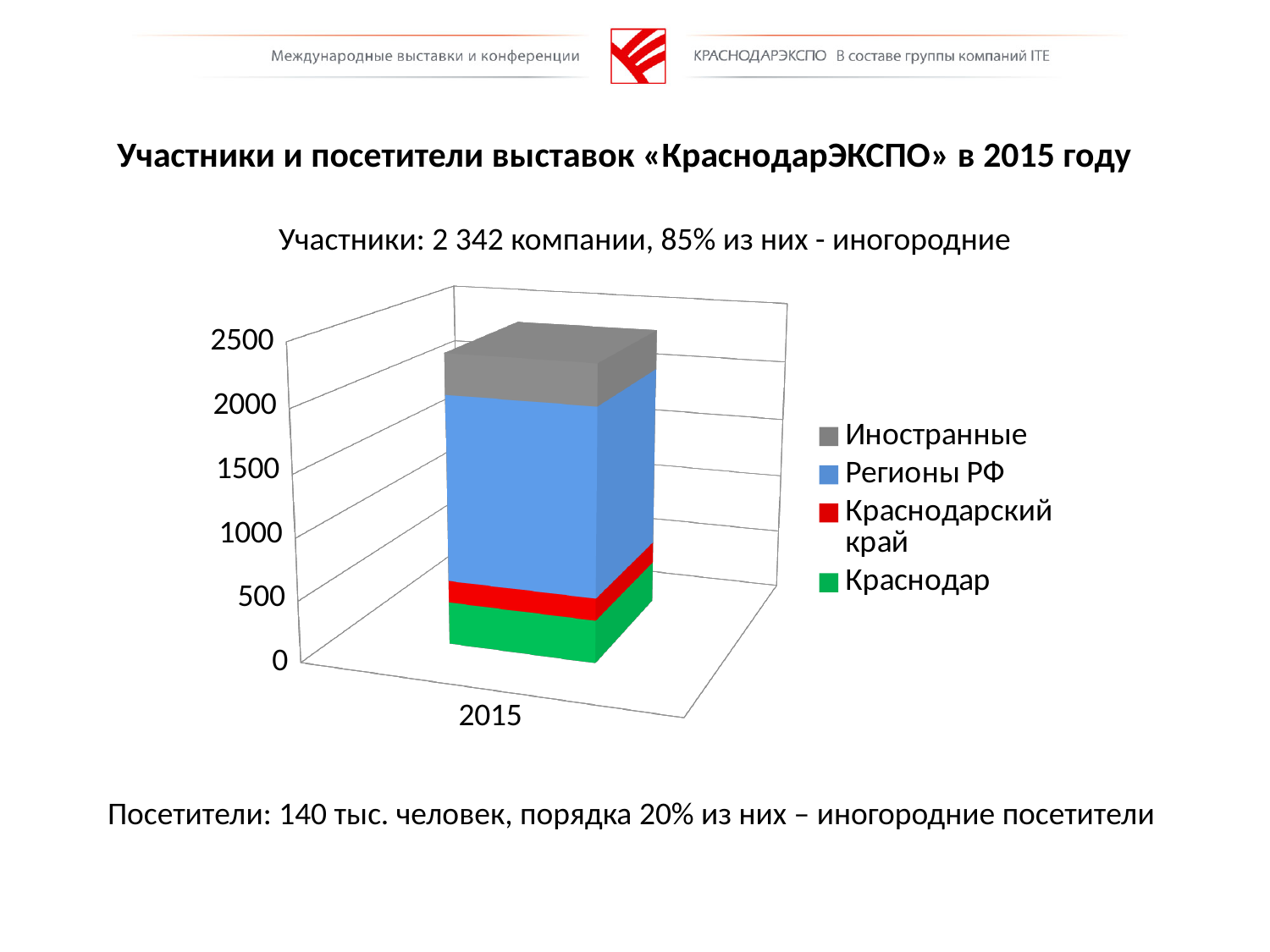
Which series forms the smallest segment of the stacked bar? Краснодарский край Is the total height of the stacked bar for 2015 greater or less than 2500? less Which series forms the largest segment of the stacked bar? Регионы РФ Is the total height of the stacked bar for 2015 greater or less than 2000? greater According to the text above the chart, what is the total number of participant companies represented by the stacked bar? 2 342 How many categories are shown on the x axis of the chart? 1 Which segment is larger in the stacked bar: Краснодар or Краснодарский край? Краснодар Which segment is larger in the stacked bar: Регионы РФ or Иностранные? Регионы РФ What colour represents the series Иностранные in the chart? Grey What kind of chart is shown on the slide? Stacked bar chart How many series does the chart legend list? 4 Which year is shown on the x axis of the chart? 2015